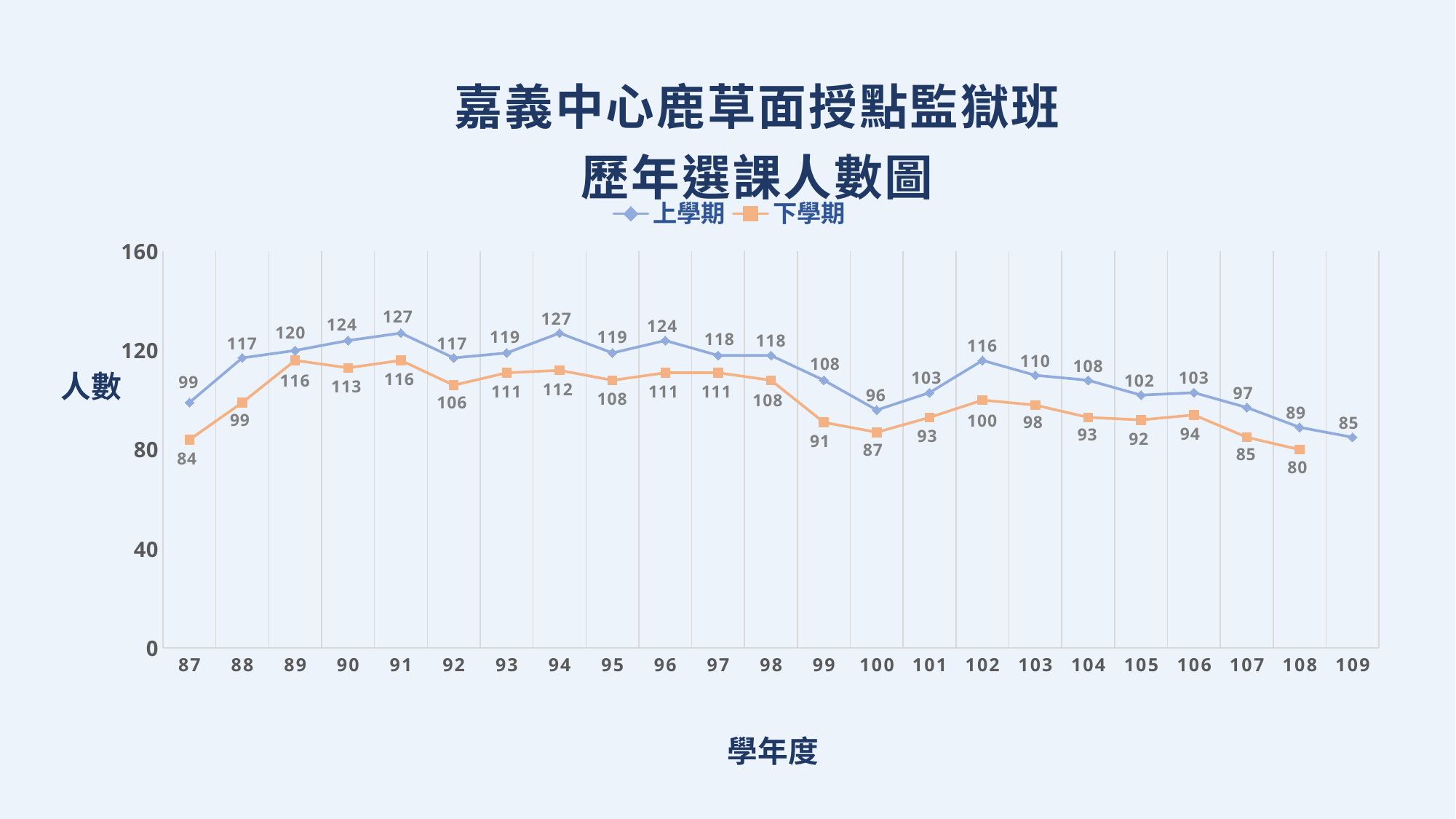
What is the value for 下學期 in academic year 99? 91 Is the 上學期 value for academic year 91 greater or less than 120? greater What is the difference between the 下學期 values in academic years 89 and 87? 32 In which academic year is the 下學期 value lowest? 108 What is the difference between the 上學期 and 下學期 values in academic year 100? 9 Which academic year has the larger 上學期 value, 102 or 103? 102 How many series does the legend list? 2 How many academic years are shown on the x axis? 23 Does the 上學期 value rise or fall from academic year 102 to 109? fall What is the value for 上學期 in academic year 90? 124 What kind of chart is shown on the slide? line chart In which academic year is the 上學期 value lowest? 109